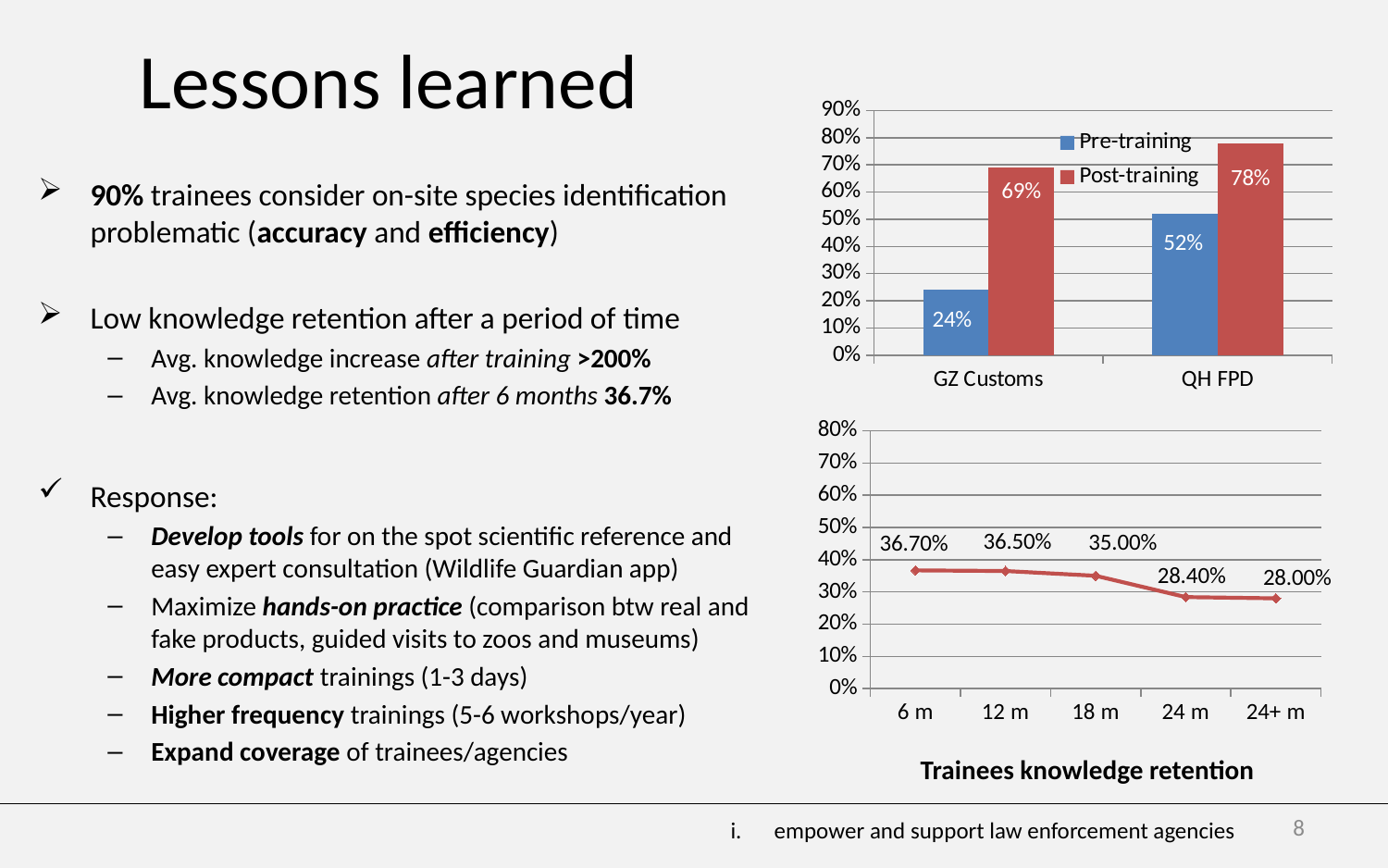
In the 'Trainees knowledge retention' chart, what is the value at 18 m? 35.00% In the top bar chart, how many series does the legend list? 2 What kind of chart is the top chart on the slide? Bar chart In the top bar chart, what are the two series named in the legend? Pre-training and Post-training In the top bar chart, what is the Pre-training value for GZ Customs? 24% In the top bar chart, what is the difference between the Post-training and Pre-training values for GZ Customs? 45% In the 'Trainees knowledge retention' chart, which point has the lowest value? 24+ m In the 'Trainees knowledge retention' chart, how many data points are plotted? 5 In the top bar chart, which category has the higher Pre-training value, GZ Customs or QH FPD? QH FPD In the 'Trainees knowledge retention' chart, what is the difference between the values at 6 m and 24+ m? 8.70% In the 'Trainees knowledge retention' chart, do the values rise or fall from 6 m to 24+ m? Fall In the top bar chart, what is the Post-training value for QH FPD? 78%